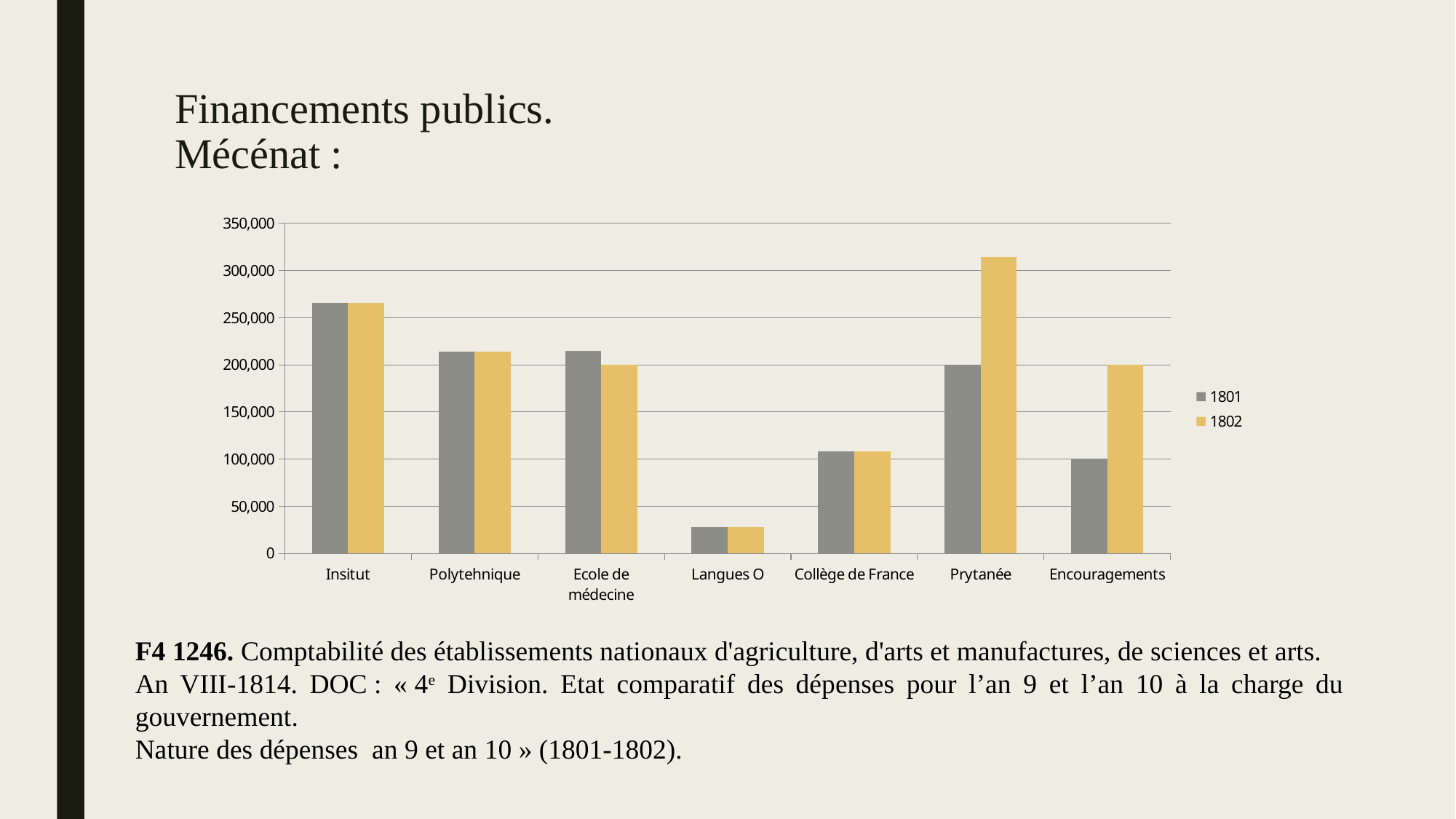
How many series does the legend list? 2 Which category has the highest bar in the chart? Prytanée How many categories are shown on the x axis? 7 Which category has the lowest values in the chart? Langues O What is the value for Prytanée in 1801? 200,000 What is the value for Encouragements in 1802? 200,000 Is the value for Prytanée in 1802 greater or less than 300,000? greater Is the value for Langues O in 1801 greater or less than 50,000? less What is the difference between the 1802 and 1801 values for Encouragements? 100,000 What is the value for Encouragements in 1801? 100,000 For Prytanée, which year has the larger value, 1801 or 1802? 1802 What kind of chart is shown on the slide? bar chart